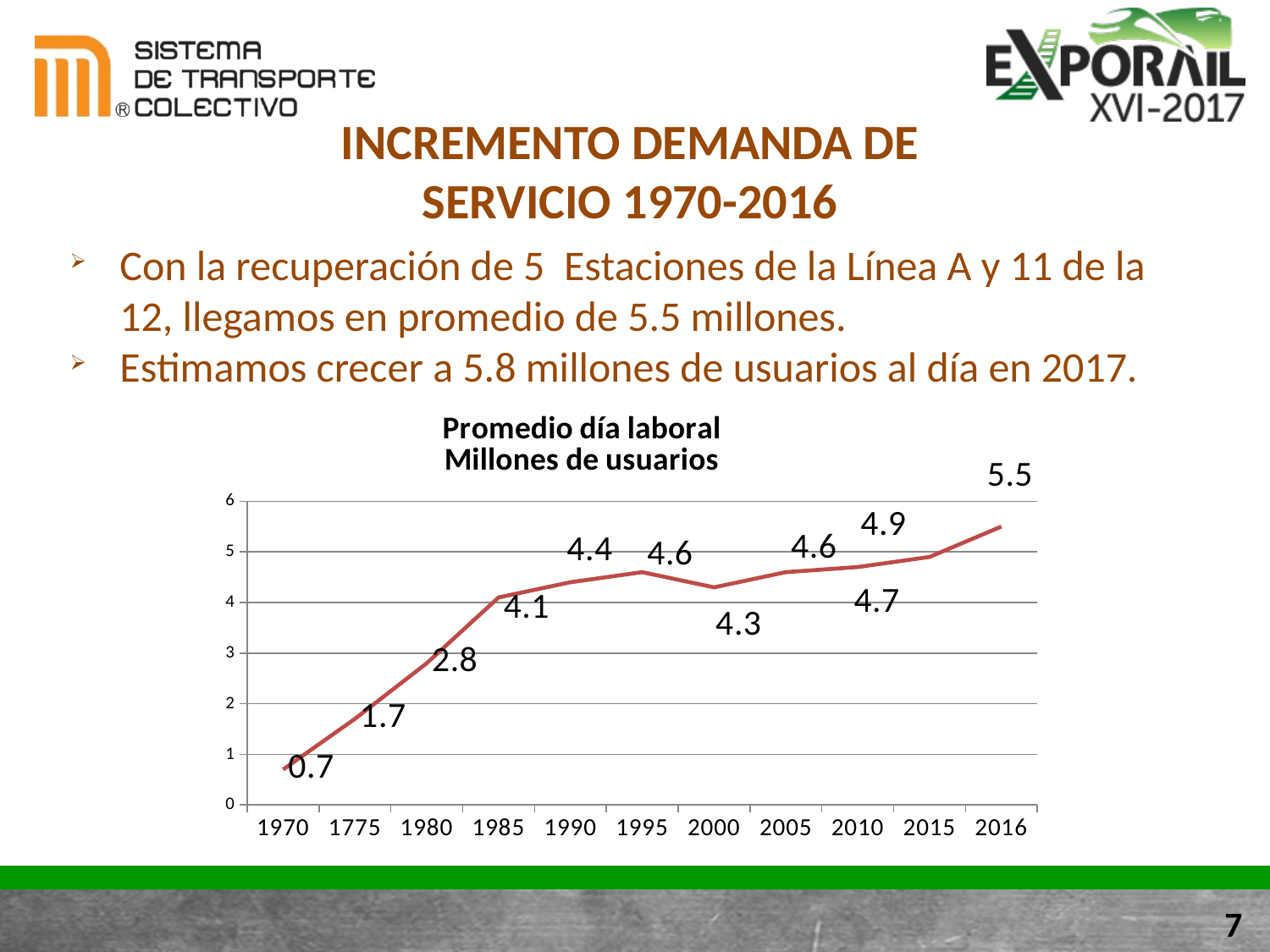
Which year has the highest value in the chart? 2016 What kind of chart is shown on the slide? Line chart How many data points are plotted in the chart? 11 What is the value for 2000 in the chart? 4.3 What is the difference between the values for 2016 and 2015? 0.6 What is the value for 2016 in the chart? 5.5 Which year has the lowest value in the chart? 1970 Which is larger, the value for 1995 or the value for 2000? 1995 What is the title of the chart? Promedio día laboral Millones de usuarios What is the difference between the values for 2016 and 1970? 4.8 What is the value for 1985 in the chart? 4.1 What is the value for 1970 in the chart? 0.7